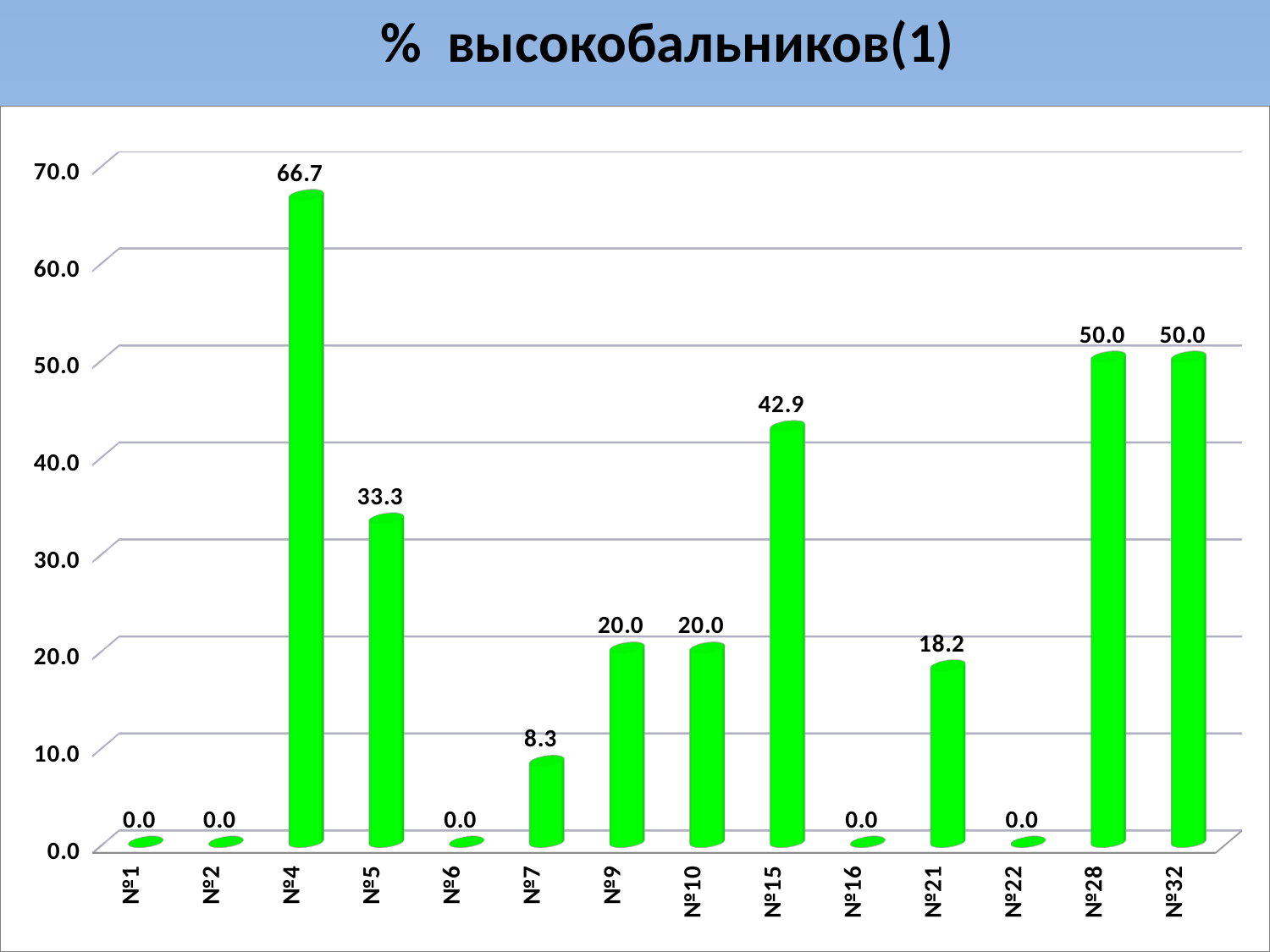
What is the value for №15? 42.9 What is the value for №4? 66.7 What is the value for №7? 8.3 Which category has the highest value? №4 How many categories have a value of 0.0? 5 What is the difference between the values for №15 and №21? 24.7 Which is larger, the value for №5 or the value for №15? №15 What type of chart is shown on the slide? bar chart What is the value for №21? 18.2 How many categories are shown on the x axis? 14 What is the difference between the values for №4 and №5? 33.4 Is the value for №28 greater or less than 40.0? greater